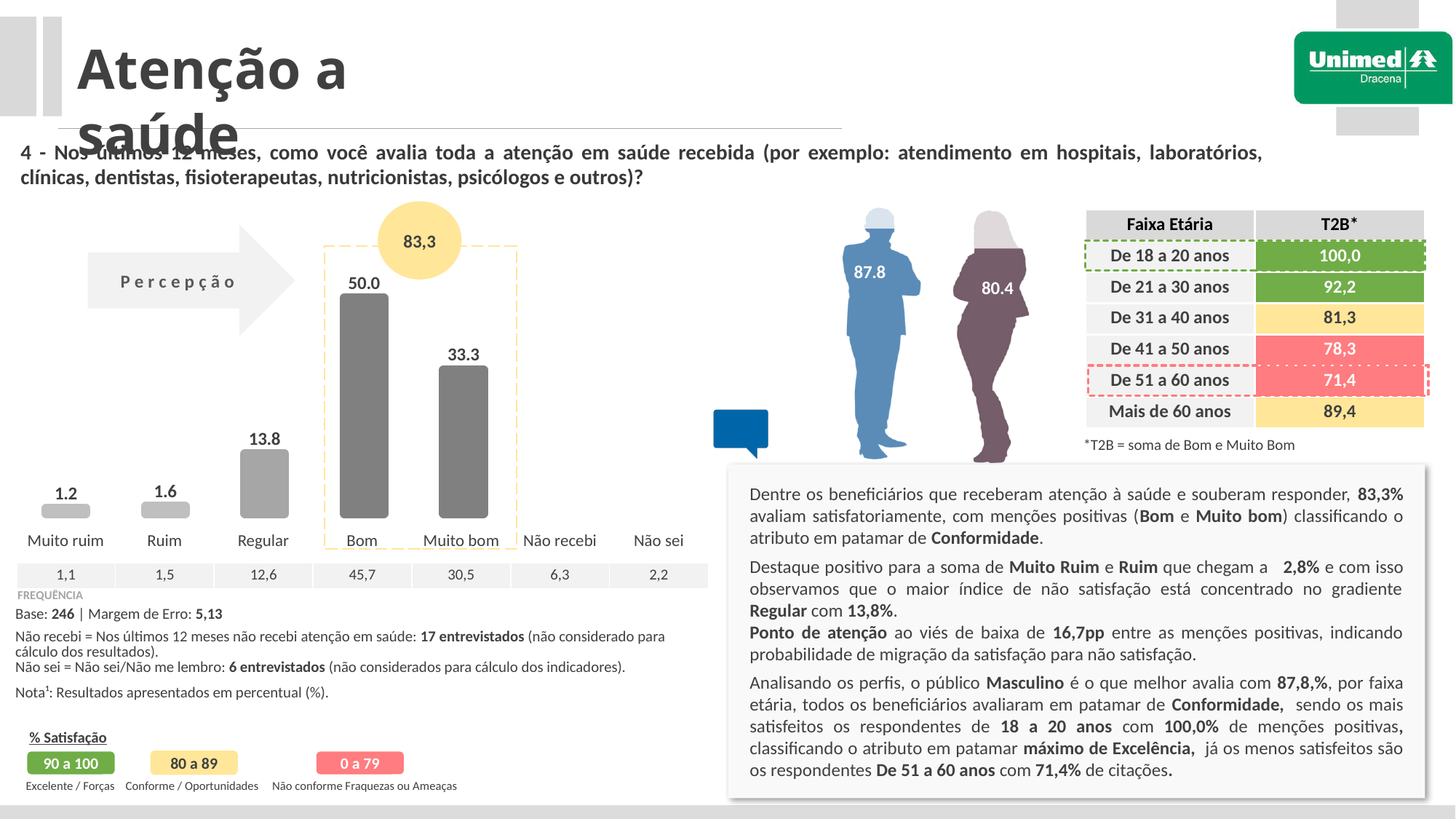
What is the value for Bom in the bar chart? 50.0 Which category has the lowest bar in the chart? Muito ruim What kind of chart is shown on the left of the slide? bar chart What is the value for Regular in the bar chart? 13.8 Which category has the highest bar in the chart? Bom What is the value for Muito bom in the bar chart? 33.3 Do the bar values rise or fall from Muito ruim to Bom? rise What is the difference between the values for Bom and Muito bom in the bar chart? 16.7 Which is larger in the bar chart, the value for Regular or the value for Muito bom? Muito bom What value is shown in the yellow circle above the highlighted bars? 83,3 What is the sum of the values for Bom and Muito bom in the bar chart? 83.3 What is the value for Ruim in the bar chart? 1.6